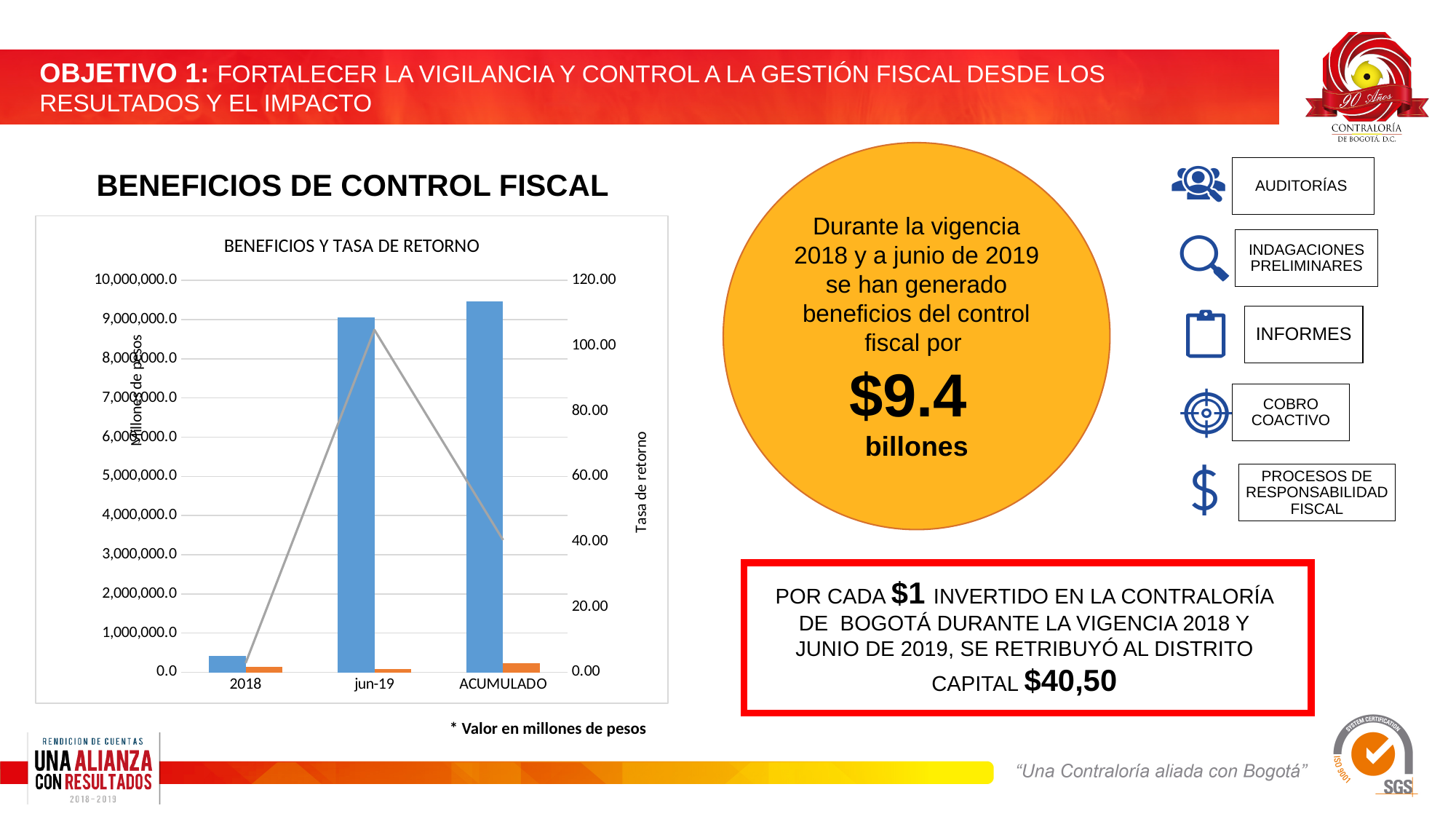
Which has a taller blue bar, 2018 or jun-19? jun-19 Is the blue bar for ACUMULADO greater or less than 9,000,000.0? greater What kind of chart is shown on the slide? Combined bar and line chart Is the blue bar for 2018 greater or less than 1,000,000.0? less What is the title of the right-hand vertical axis of the chart? Tasa de retorno Which category has the shortest blue bar in the chart? 2018 What is the title of the chart on the slide? BENEFICIOS Y TASA DE RETORNO Is the gray line value for ACUMULADO greater or less than 60.00 on the right axis? less Which category has the tallest blue bar in the chart? ACUMULADO How many categories are shown on the x axis of the chart? 3